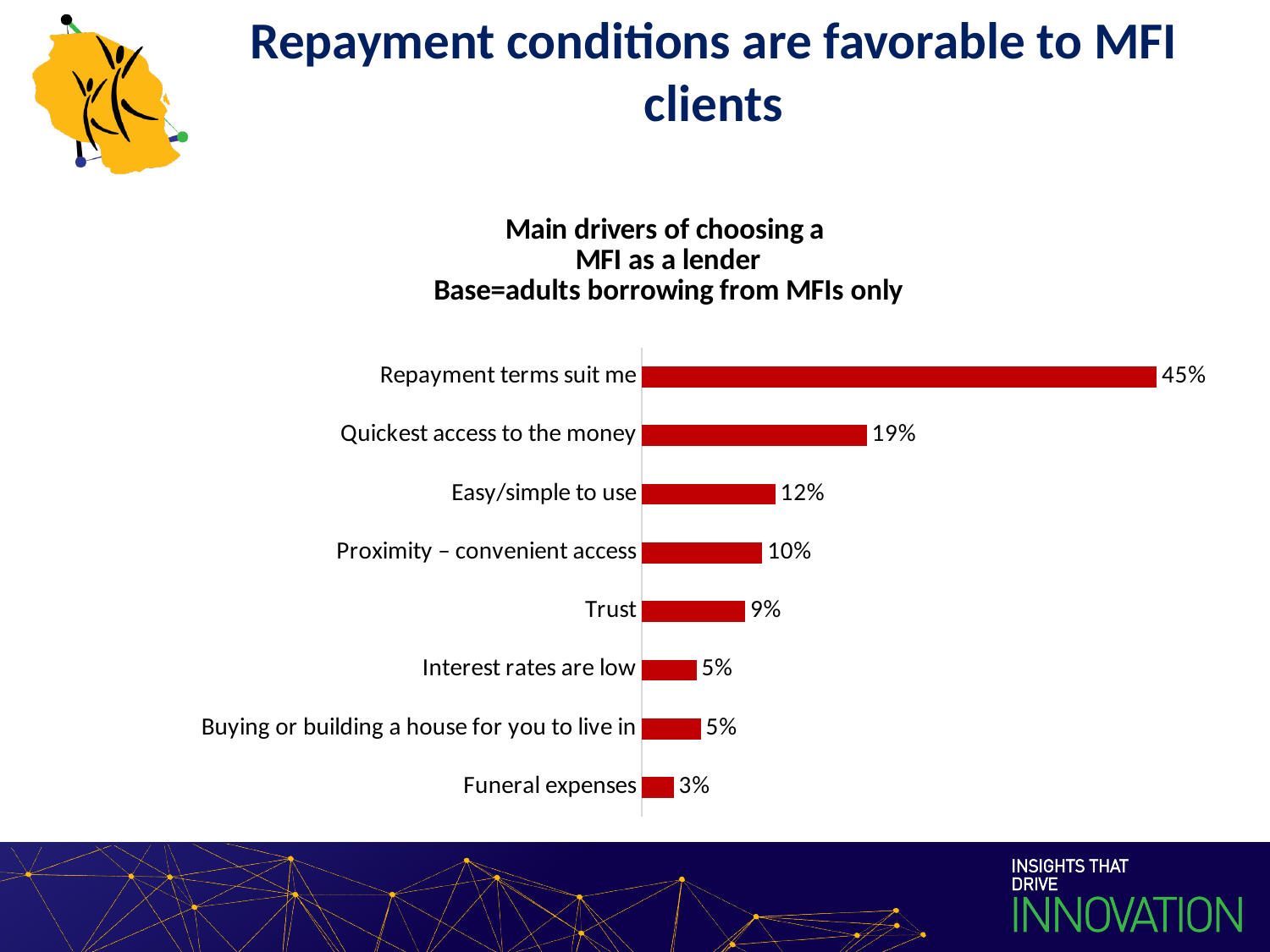
What is the value for 'Proximity – convenient access'? 10% What is the difference between 'Easy/simple to use' and 'Funeral expenses'? 9% Which is larger: 'Easy/simple to use' or 'Trust'? Easy/simple to use What percentage of MFI borrowers cited 'Repayment terms suit me' as a main driver? 45% Which driver has the highest value? Repayment terms suit me What is the base population stated in the chart title? Adults borrowing from MFIs only What is the value for 'Quickest access to the money'? 19% What kind of chart is shown on the slide? Bar chart What is the difference between 'Repayment terms suit me' and 'Quickest access to the money'? 26% Which driver has the lowest value? Funeral expenses How many drivers are shown in the chart? 8 What is the value for 'Trust'? 9%